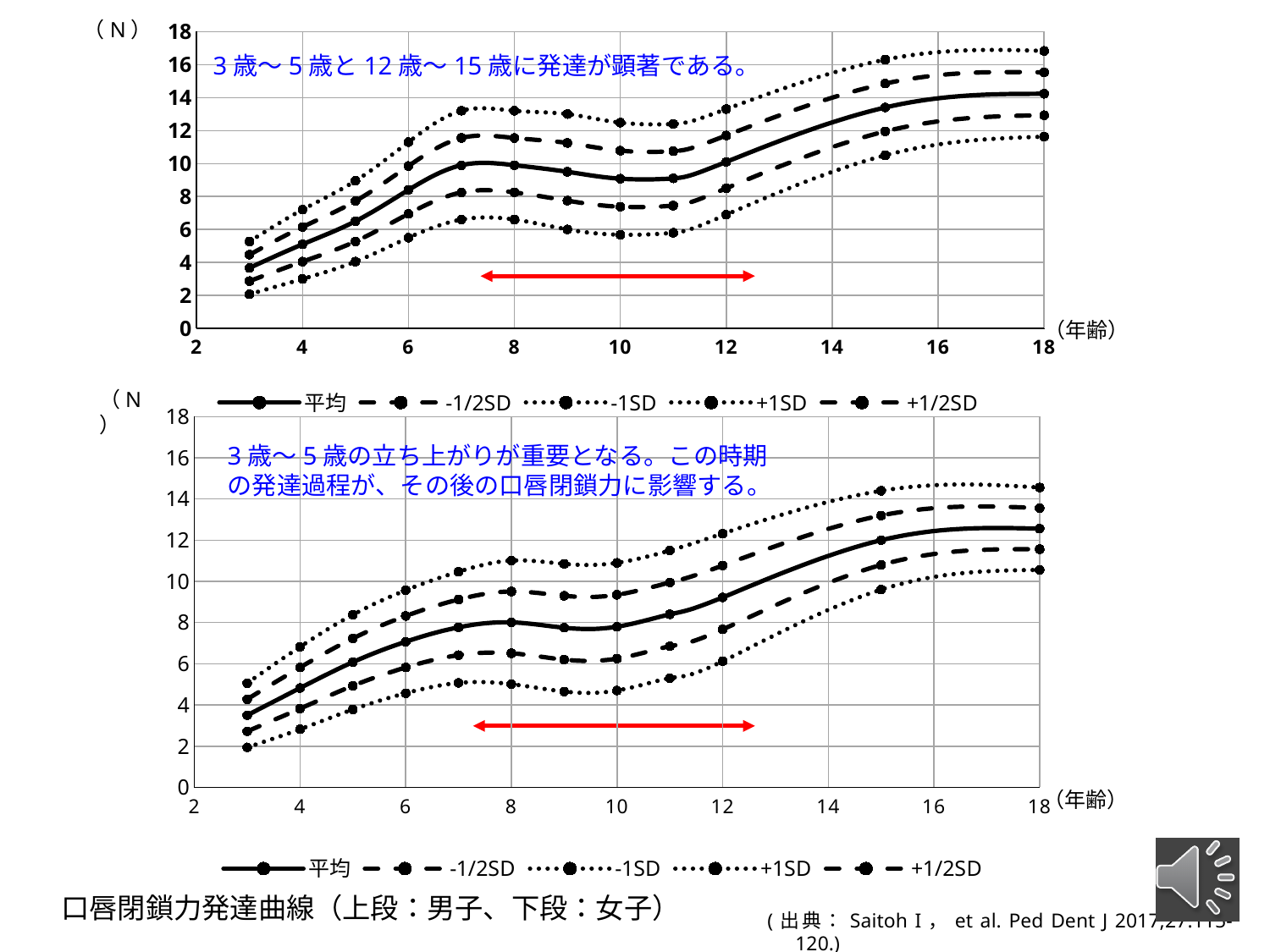
In the top chart (男子), is the value of the +1SD series at age 18 greater or less than 16? greater In the bottom chart (女子), is the value of the 平均 series at age 18 greater or less than 12? greater What kind of chart is the top chart on the slide? line chart What is the unit shown on the vertical axis of both charts? N In the bottom chart (女子), is the value of the 平均 series at age 3 greater or less than 6? less How many series does the legend of the top chart list? 5 How many data points does each series in the bottom chart (女子) have? 12 Does the 平均 series in the bottom chart (女子) generally rise or fall as age increases from 3 to 18? rise In the top chart (男子), at which age is the 平均 series lowest? 3 In the top chart (男子), which is larger: the 平均 value at age 3 or at age 18? age 18